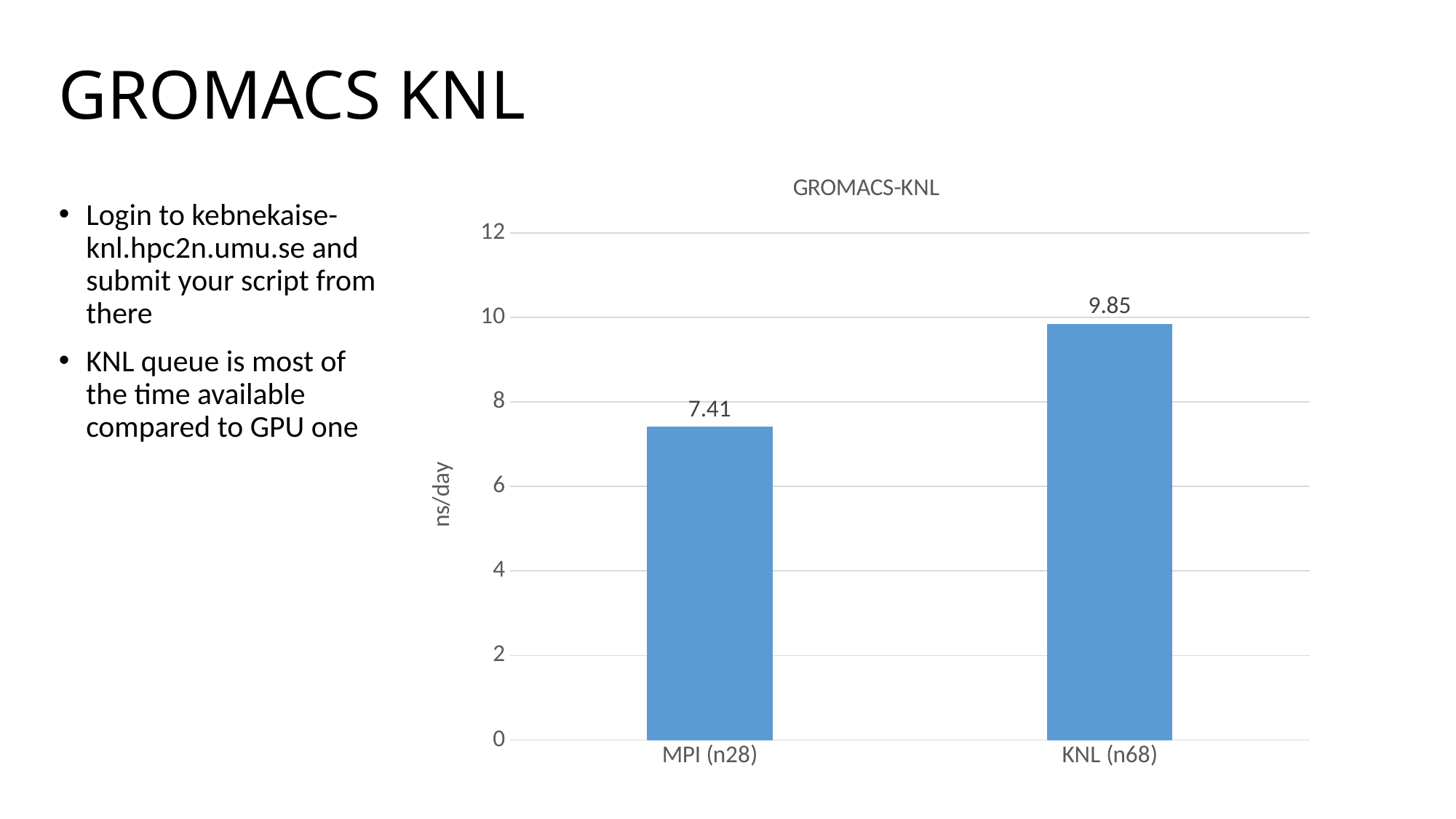
How many categories are shown on the x axis? 2 What kind of chart is shown? bar chart Which category has the highest value? KNL (n68) Is the value for MPI (n28) greater or less than 8? less What is the value for MPI (n28)? 7.41 What is the value for KNL (n68)? 9.85 Which category has the lowest value? MPI (n28) What is the difference between the values for KNL (n68) and MPI (n28)? 2.44 What is the label of the y axis? ns/day What is the title of the chart? GROMACS-KNL Which is larger, the value for MPI (n28) or the value for KNL (n68)? KNL (n68) Is the value for KNL (n68) greater or less than 8? greater